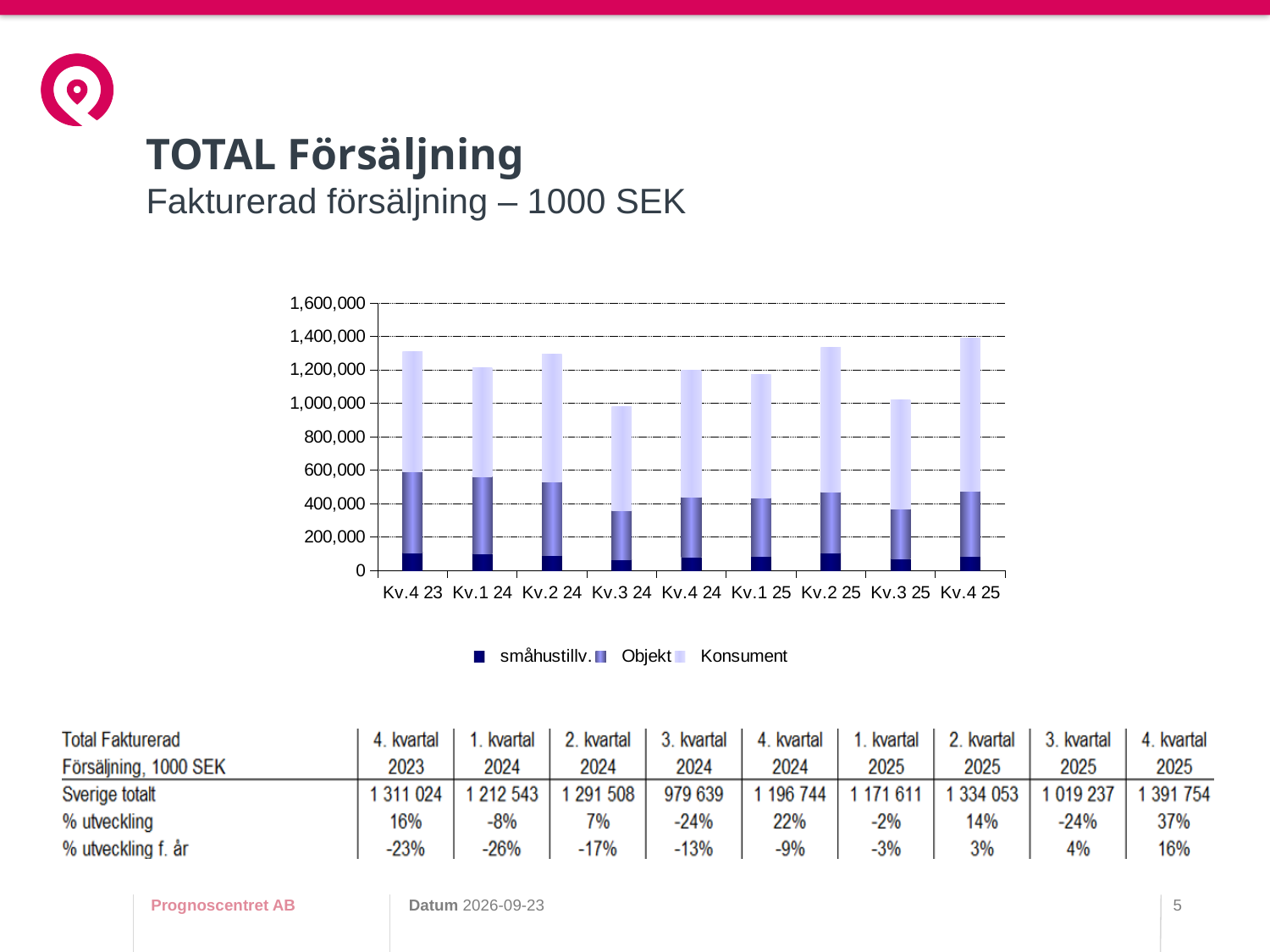
How many series does the chart legend list? 3 Which quarter has the lowest total bar in the chart? Kv.3 24 How many quarters are shown on the x axis of the chart? 9 Which total bar is taller, Kv.4 23 or Kv.1 24? Kv.4 23 Using the totals in the table below the chart, what is the difference between the 4th quarter 2025 and 3rd quarter 2025 totals? 372 517 Is the total bar for Kv.3 24 greater or less than 1,200,000? less According to the table below the chart, what is the total invoiced sales (Sverige totalt) for the 3rd quarter of 2024? 979 639 Which series forms the largest segment of each stacked bar? Konsument Which quarter has the highest total bar in the chart? Kv.4 25 What are the three series listed in the chart legend? småhustillv., Objekt, Konsument What kind of chart is shown on the slide? Stacked bar chart Is the total bar for Kv.4 25 greater or less than 1,200,000? greater